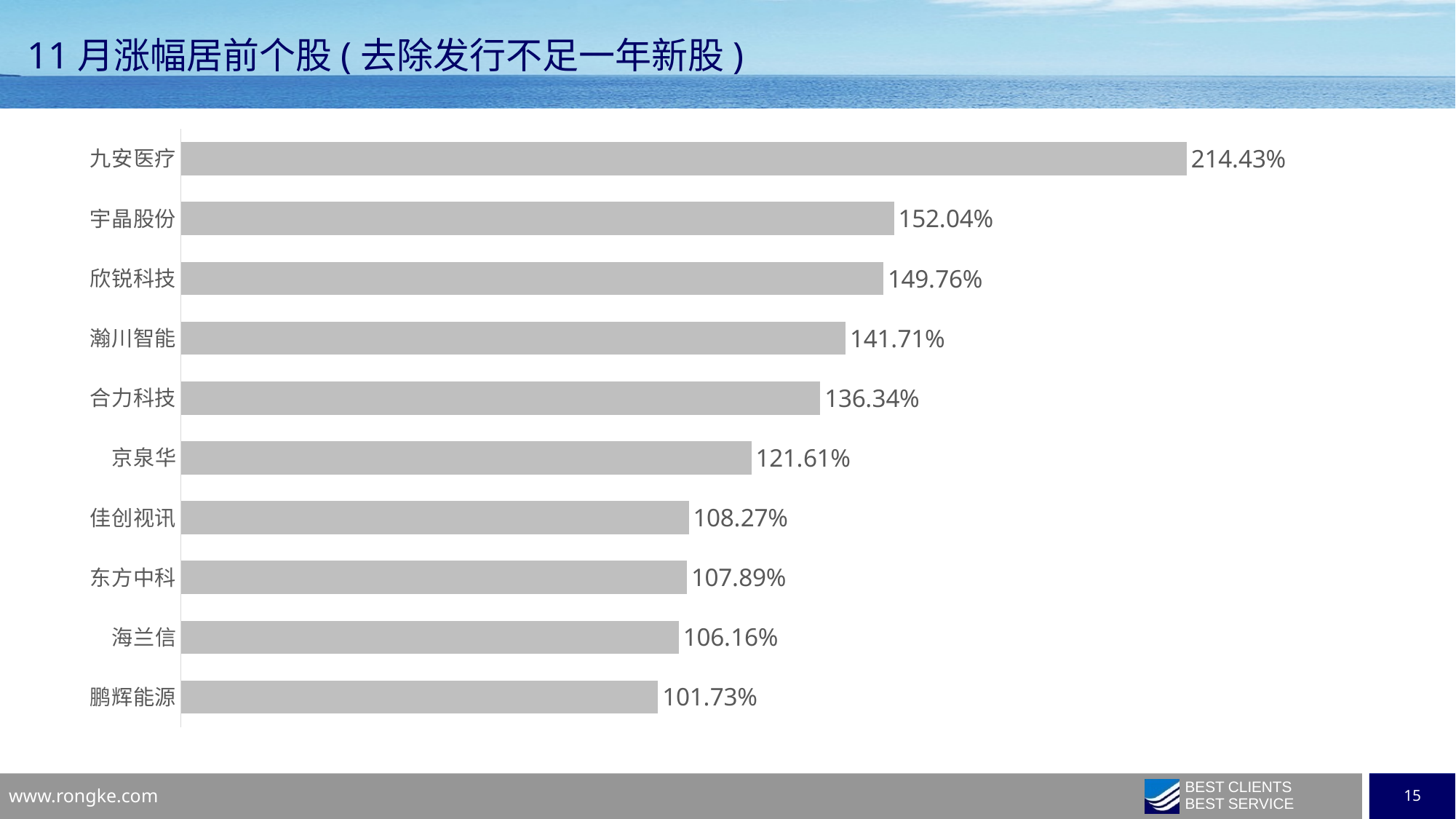
What is the value for 海兰信? 106.16% Which stock has the highest value? 九安医疗 What is the difference between the values for 京泉华 and 鹏辉能源? 19.88% Which is larger, the value for 欣锐科技 or the value for 瀚川智能? 欣锐科技 What kind of chart is shown on the slide? bar chart What is the difference between the values for 九安医疗 and 宇晶股份? 62.39% What is the value for 九安医疗? 214.43% What is the value for 合力科技? 136.34% Which stock has the lowest value? 鹏辉能源 What colour are the bars in the chart? grey What is the title of the slide? 11 月涨幅居前个股 ( 去除发行不足一年新股 ) How many stocks are shown in the chart? 10